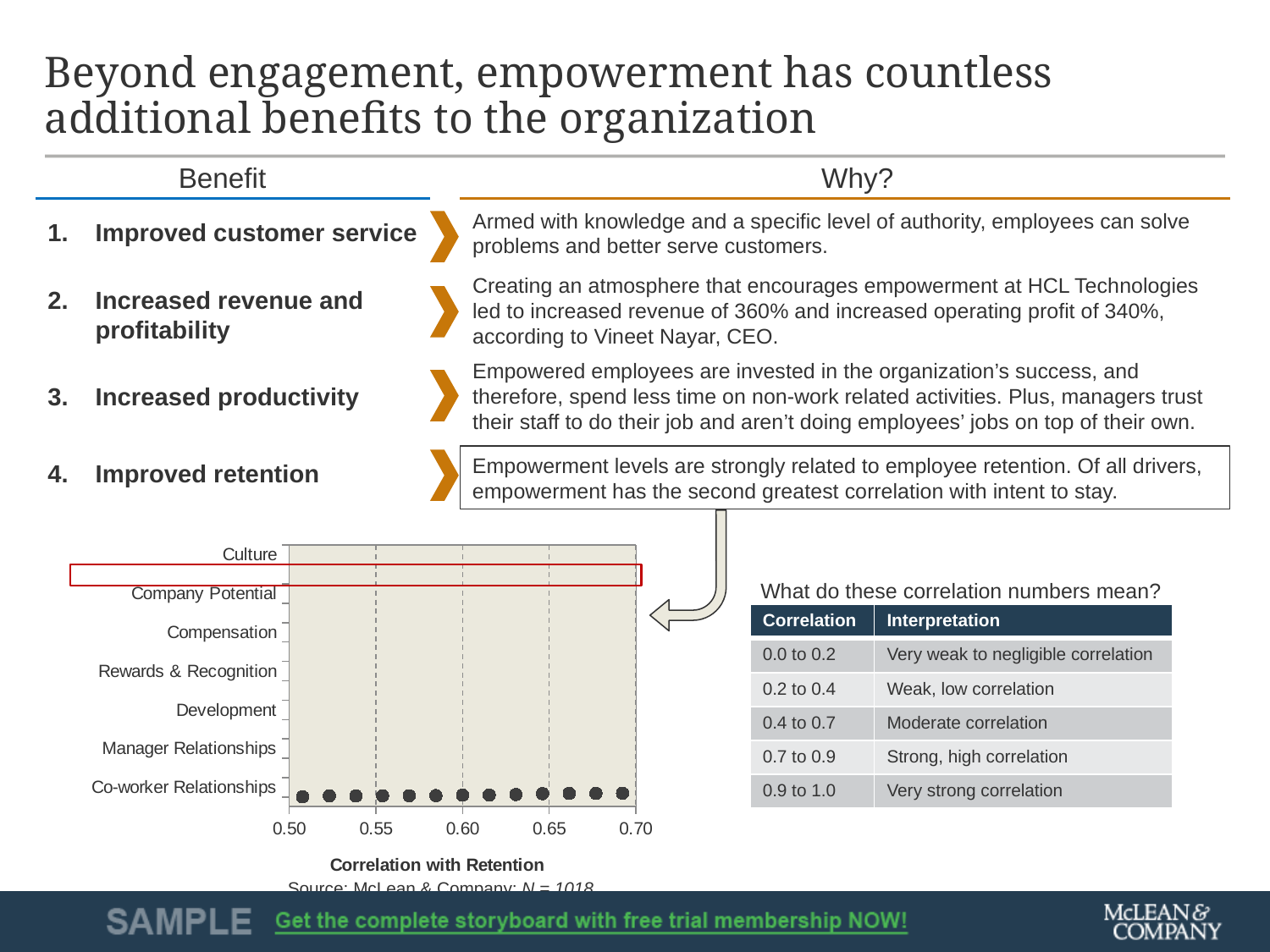
What is the lowest value shown on the x axis of the correlation chart? 0.50 What is the highest value shown on the x axis of the correlation chart? 0.70 Which category label appears at the top of the y axis on the correlation chart? Culture What is the title of the x axis on the chart at the bottom left of the slide? Correlation with Retention